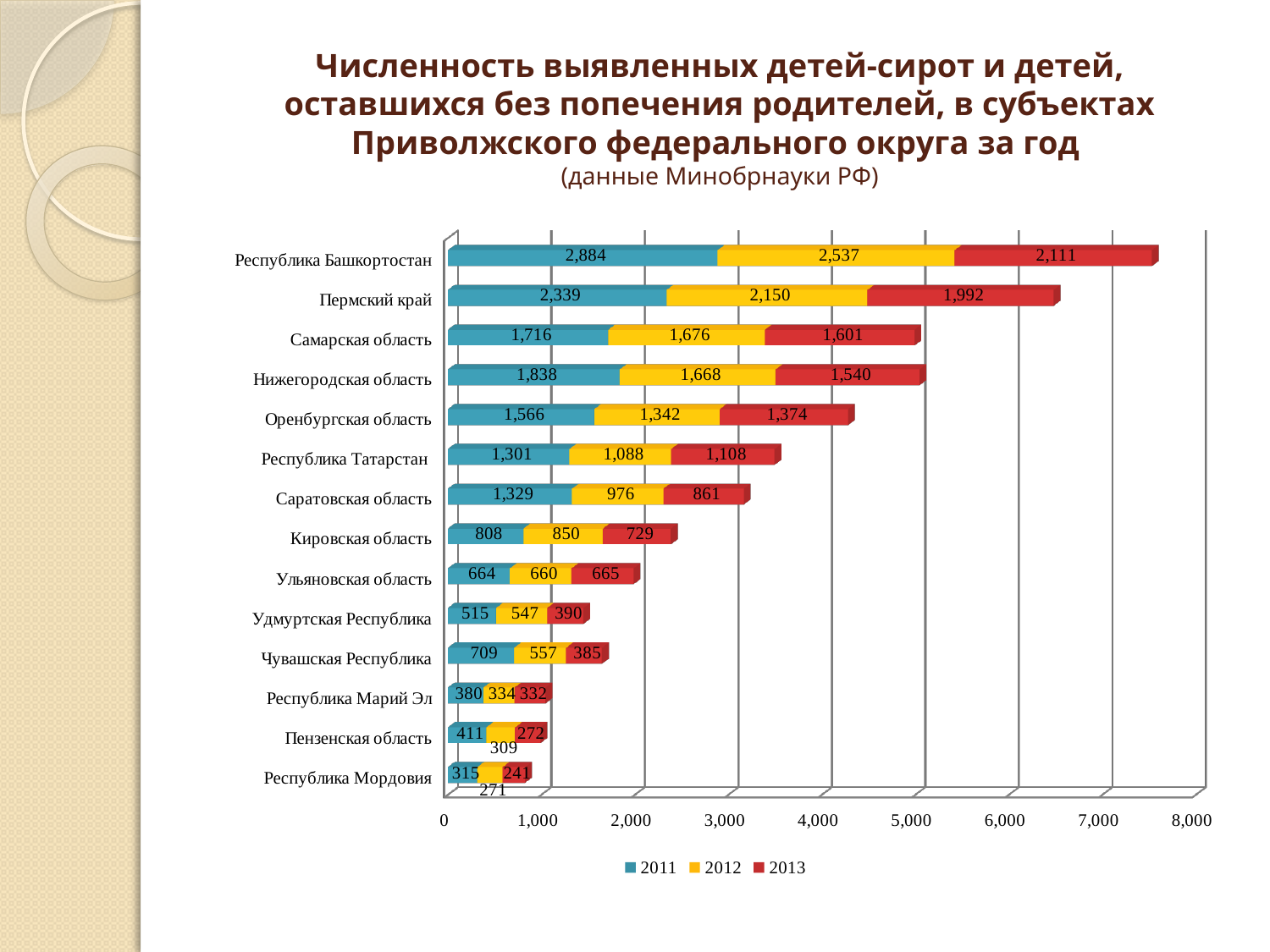
How many regions are shown on the chart? 14 What is the 2013 value for Пермский край? 1,992 Which region has the lowest 2013 value? Республика Мордовия What is the difference between the 2011 and 2013 values for Республика Башкортостан? 773 What kind of chart is shown on the slide? Stacked bar chart Which is larger: the 2011 value for Чувашская Республика or the 2011 value for Удмуртская Республика? Чувашская Республика What is the 2011 value for Республика Башкортостан? 2,884 What is the 2012 value for Кировская область? 850 Is the total of the stacked bar for Оренбургская область greater or less than 5,000? less Which region has the highest 2011 value? Республика Башкортостан What is the total of the stacked bar for Ульяновская область? 1,989 How many series does the legend list? 3